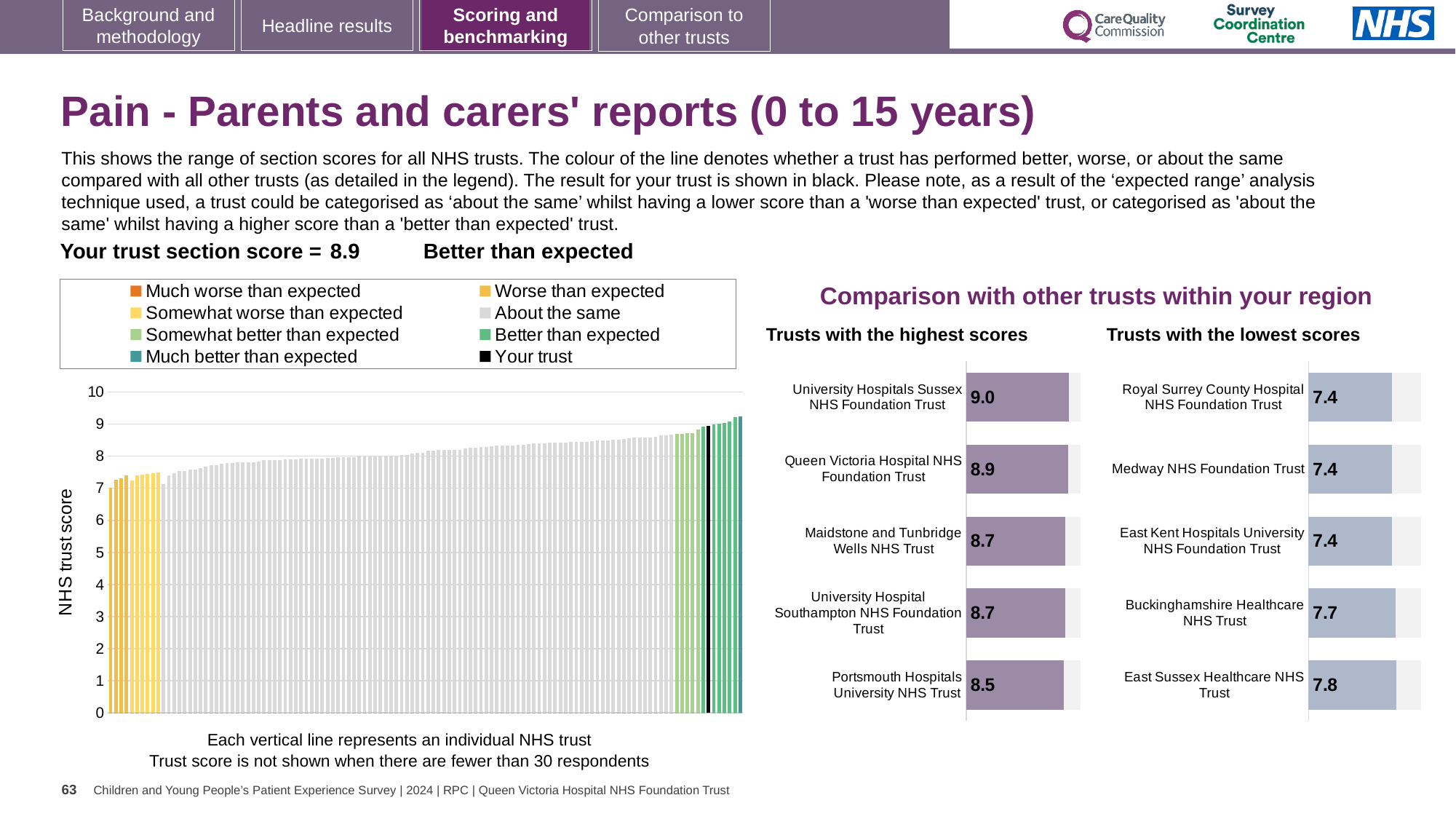
In the 'Trusts with the highest scores' chart, which trust has the highest score? University Hospitals Sussex NHS Foundation Trust In the 'Trusts with the lowest scores' chart, which trust has the highest score? East Sussex Healthcare NHS Trust In the 'Trusts with the lowest scores' chart, what is the difference between the scores of East Sussex Healthcare NHS Trust and Royal Surrey County Hospital NHS Foundation Trust? 0.4 In the 'Trusts with the lowest scores' chart, which has the larger score: Buckinghamshire Healthcare NHS Trust or Medway NHS Foundation Trust? Buckinghamshire Healthcare NHS Trust What kind of chart is the main chart on the left showing all NHS trusts? Bar chart In the 'Trusts with the highest scores' chart, what is the score for University Hospitals Sussex NHS Foundation Trust? 9.0 In the 'Trusts with the highest scores' chart, how many trusts are listed? 5 In the 'Trusts with the highest scores' chart, what is the score for Portsmouth Hospitals University NHS Trust? 8.5 In the 'Trusts with the lowest scores' chart, what is the score for East Sussex Healthcare NHS Trust? 7.8 In the 'Trusts with the lowest scores' chart, what is the score for Buckinghamshire Healthcare NHS Trust? 7.7 In the main chart on the left showing all NHS trusts, is the value for the black 'Your trust' bar greater or less than 8? greater In the 'Trusts with the highest scores' chart, what is the difference between the scores of University Hospitals Sussex NHS Foundation Trust and Portsmouth Hospitals University NHS Trust? 0.5